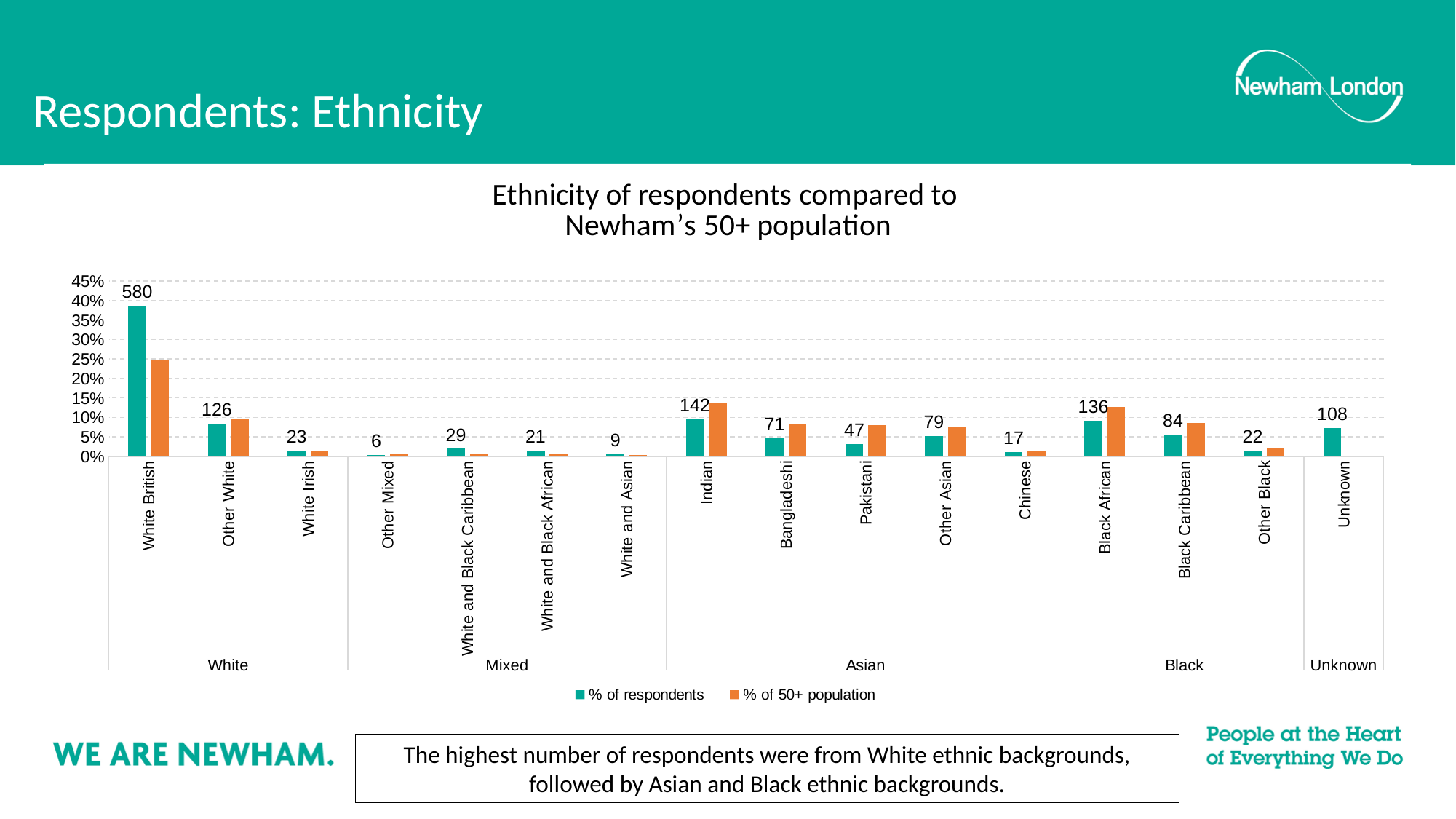
What number is labelled above the bar for Black Caribbean? 84 What kind of chart is shown on the slide? bar chart What number is labelled above the bar for Indian? 142 How many series does the chart legend list? 2 Is the % of respondents value for White British greater or less than 35%? greater Which ethnicity category has the highest labelled number of respondents? White British What is the title of the chart? Ethnicity of respondents compared to Newham's 50+ population Which ethnicity category has the lowest labelled number of respondents? Other Mixed What is the difference between the labelled numbers for White British and Other White? 454 What number is labelled above the bar for White British? 580 Which has the larger labelled number, Black African or Indian? Indian How many ethnicity categories are plotted along the x axis? 16